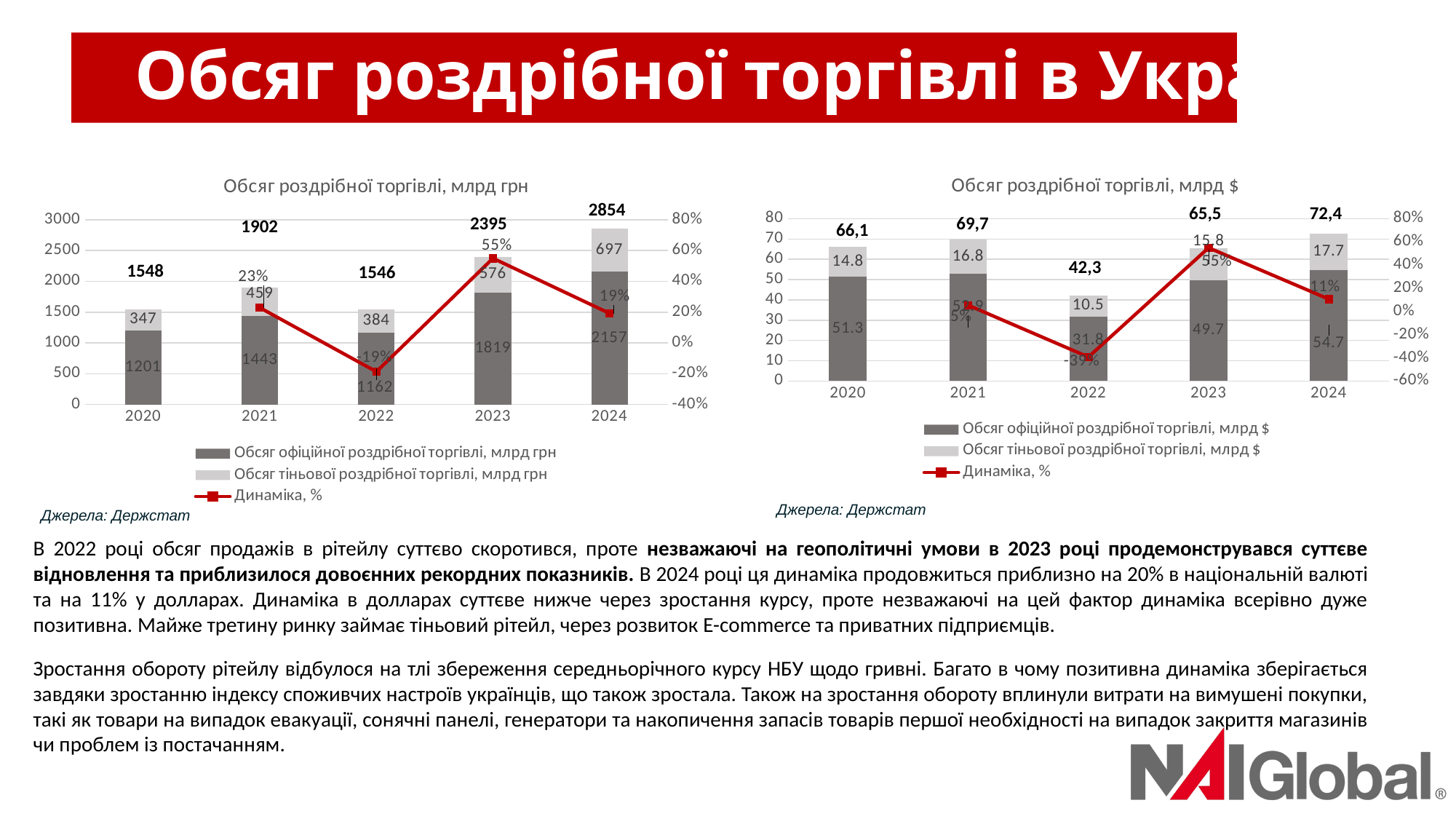
In the chart titled 'Обсяг роздрібної торгівлі, млрд грн', what is the official retail trade volume for 2023? 1819 In the chart titled 'Обсяг роздрібної торгівлі, млрд грн', which year has the lowest total retail trade volume? 2022 In the chart titled 'Обсяг роздрібної торгівлі, млрд грн', what is the total retail trade volume labelled above the bar for 2024? 2854 In the chart titled 'Обсяг роздрібної торгівлі, млрд $', is the official retail trade volume for 2022 larger or smaller than that for 2023? smaller In the chart titled 'Обсяг роздрібної торгівлі, млрд $', what is the total retail trade volume labelled above the bar for 2022? 42,3 In the chart titled 'Обсяг роздрібної торгівлі, млрд грн', what is the difference between the total for 2024 and the total for 2023? 459 In the chart titled 'Обсяг роздрібної торгівлі, млрд грн', what is the shadow retail trade volume for 2021? 459 How many series does the legend of the chart titled 'Обсяг роздрібної торгівлі, млрд $' list? 3 In the chart titled 'Обсяг роздрібної торгівлі, млрд $', which year has the highest total retail trade volume? 2024 In the chart titled 'Обсяг роздрібної торгівлі, млрд грн', what is the 'Динаміка, %' value for 2022? -19% In the chart titled 'Обсяг роздрібної торгівлі, млрд $', what is the shadow retail trade volume for 2024? 17.7 How many years are shown on the x axis of the chart titled 'Обсяг роздрібної торгівлі, млрд грн'? 5